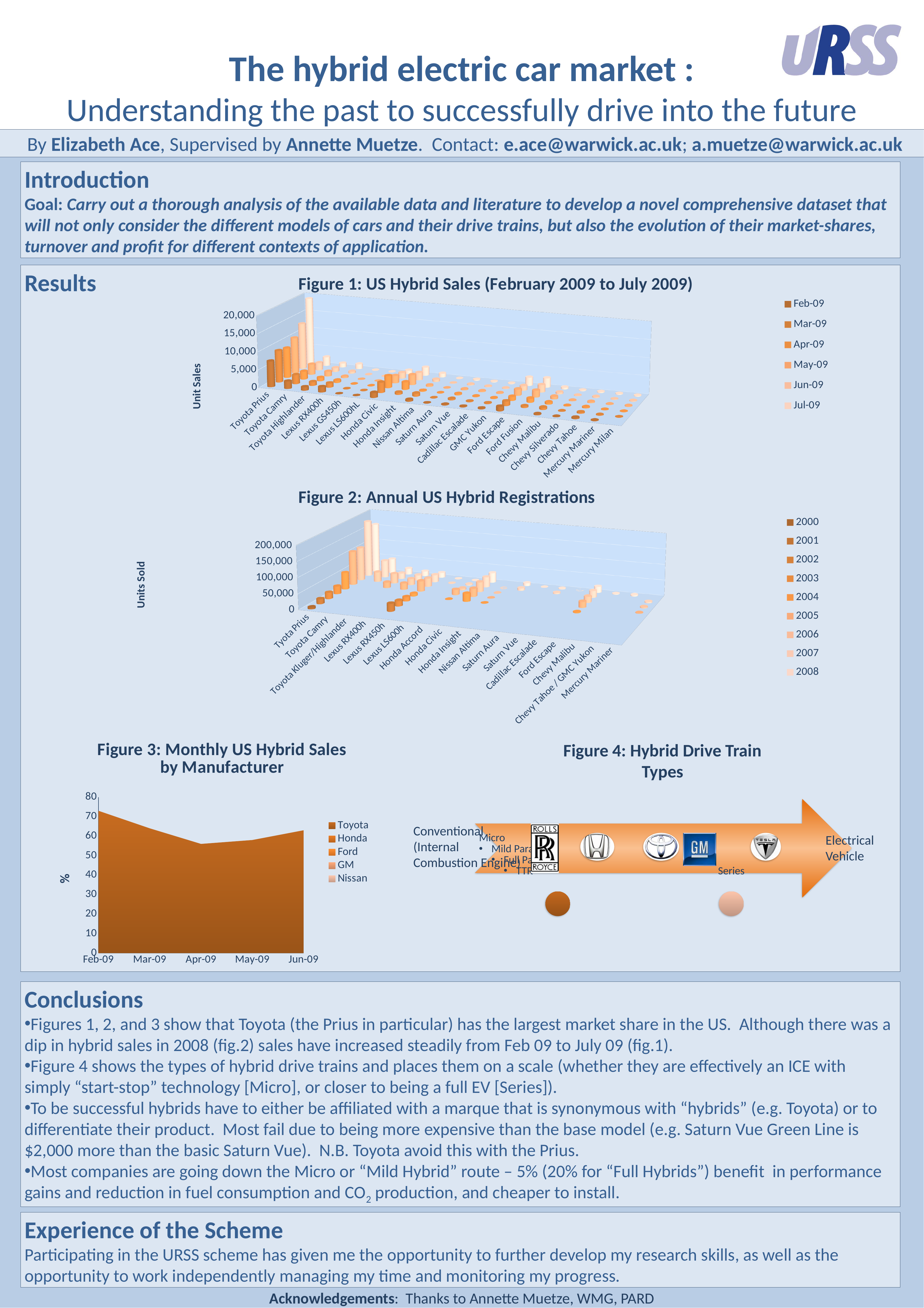
In Figure 2: Annual US Hybrid Registrations, is the 2007 value for Tyota Prius greater or less than 150,000? greater What kind of chart is Figure 3: Monthly US Hybrid Sales by Manufacturer? Area chart How many series does the legend of Figure 2: Annual US Hybrid Registrations list? 9 In Figure 1: US Hybrid Sales, is the Jul-09 value for Toyota Prius greater or less than 15,000? greater In Figure 1: US Hybrid Sales, which car model has the highest unit sales? Toyota Prius How many manufacturers does the legend of Figure 3: Monthly US Hybrid Sales by Manufacturer list? 5 What is the y-axis label of Figure 1: US Hybrid Sales? Unit Sales In Figure 3: Monthly US Hybrid Sales by Manufacturer, is the Toyota value for Apr-09 greater or less than 60? less In Figure 2: Annual US Hybrid Registrations, which car model has the highest registrations? Tyota Prius How many series does the legend of Figure 1: US Hybrid Sales list? 6 How many car models are shown on the x axis of Figure 1: US Hybrid Sales? 20 What kind of chart is Figure 1: US Hybrid Sales (February 2009 to July 2009)? Bar chart